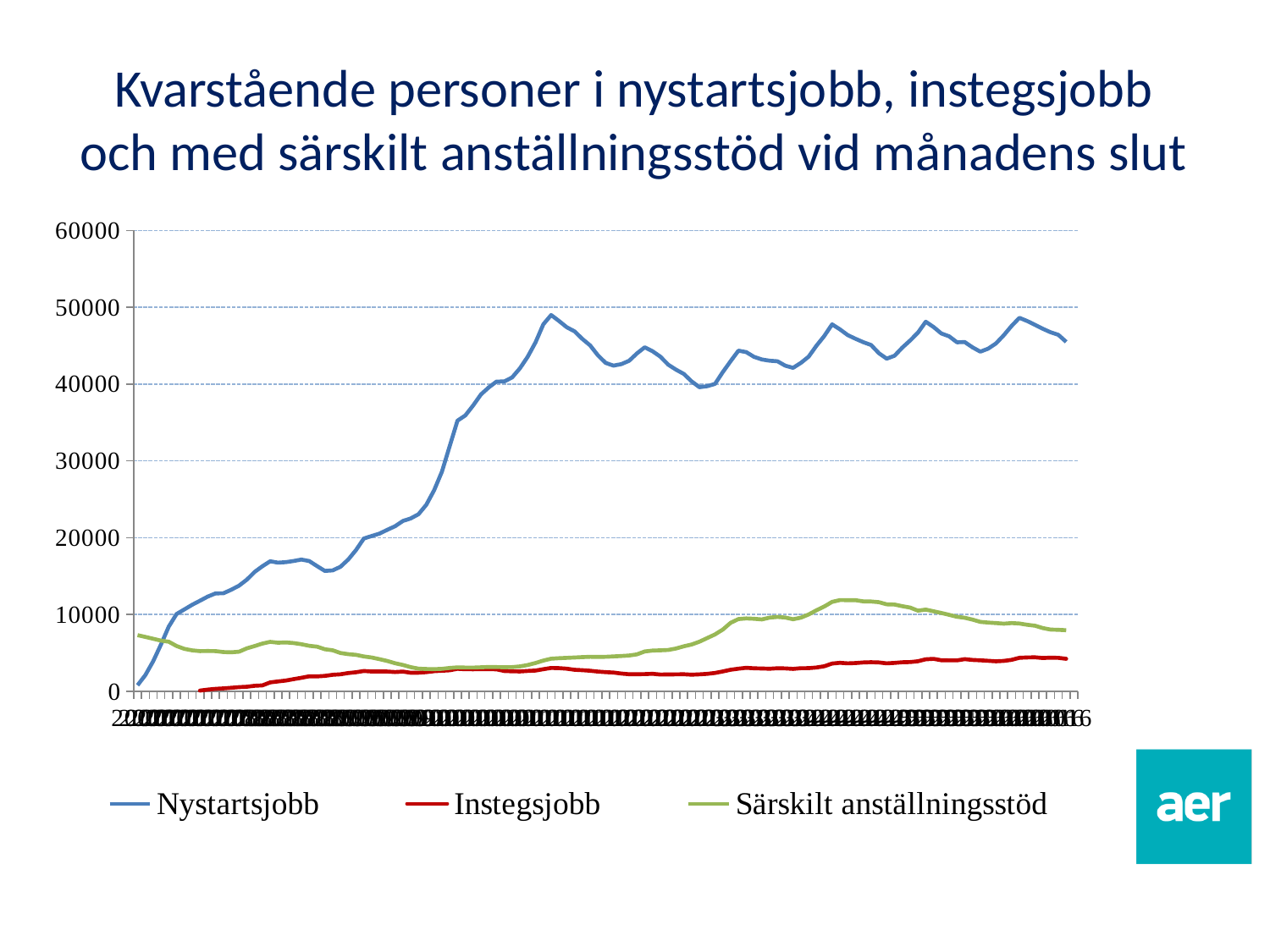
What are the three series named in the legend? Nystartsjobb, Instegsjobb, Särskilt anställningsstöd How many series does the legend list? 3 Is the value for Nystartsjobb at the end of the period greater or less than 40000? greater Which series has the lowest values at the end of the period? Instegsjobb At the start of the period, which series is higher: Nystartsjobb or Särskilt anställningsstöd? Särskilt anställningsstöd Does the Nystartsjobb series overall rise or fall from the start to the end of the period? rise At the end of the period, which series is higher: Nystartsjobb or Särskilt anställningsstöd? Nystartsjobb Is the highest value reached by Särskilt anställningsstöd greater or less than 10000? greater What is the title of the chart? Kvarstående personer i nystartsjobb, instegsjobb och med särskilt anställningsstöd vid månadens slut What kind of chart is shown on the slide? line chart Is the highest value reached by Nystartsjobb greater or less than 50000? less Which series reaches the highest values on the chart? Nystartsjobb